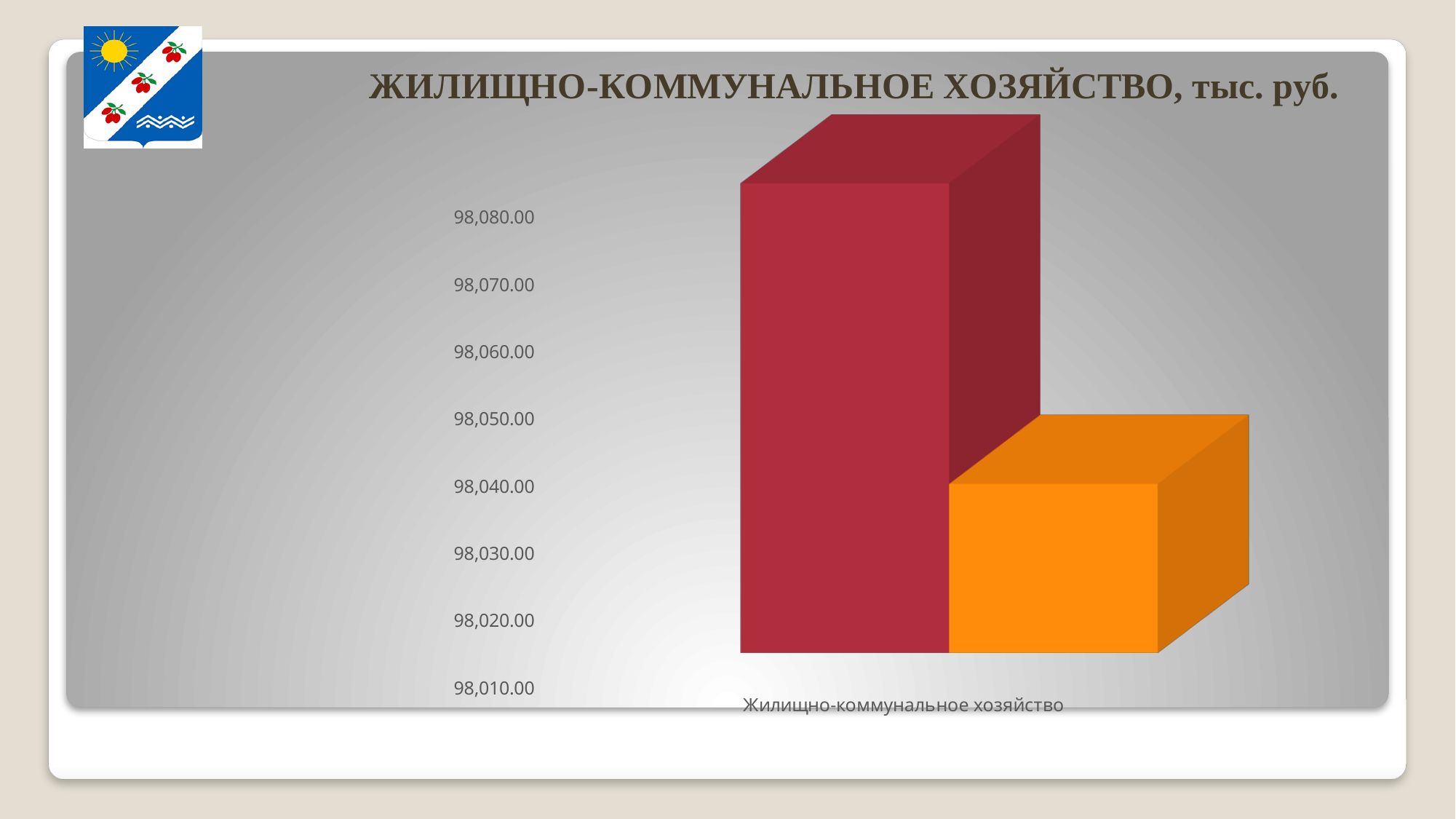
Is the value of the orange bar greater or less than 98,030.00? greater What is the lowest value shown on the y axis of the chart? 98,010.00 What is the title of the chart? ЖИЛИЩНО-КОММУНАЛЬНОЕ ХОЗЯЙСТВО, тыс. руб. How many categories are shown on the x axis of the chart? 1 Is the value of the orange bar greater or less than 98,060.00? less Which bar shows the lowest value in the chart? the orange bar Is the value of the orange bar greater or less than 98,050.00? less What is the category label shown on the x axis? Жилищно-коммунальное хозяйство What kind of chart is shown on the slide? bar chart Which bar is taller, the red bar or the orange bar? the red bar